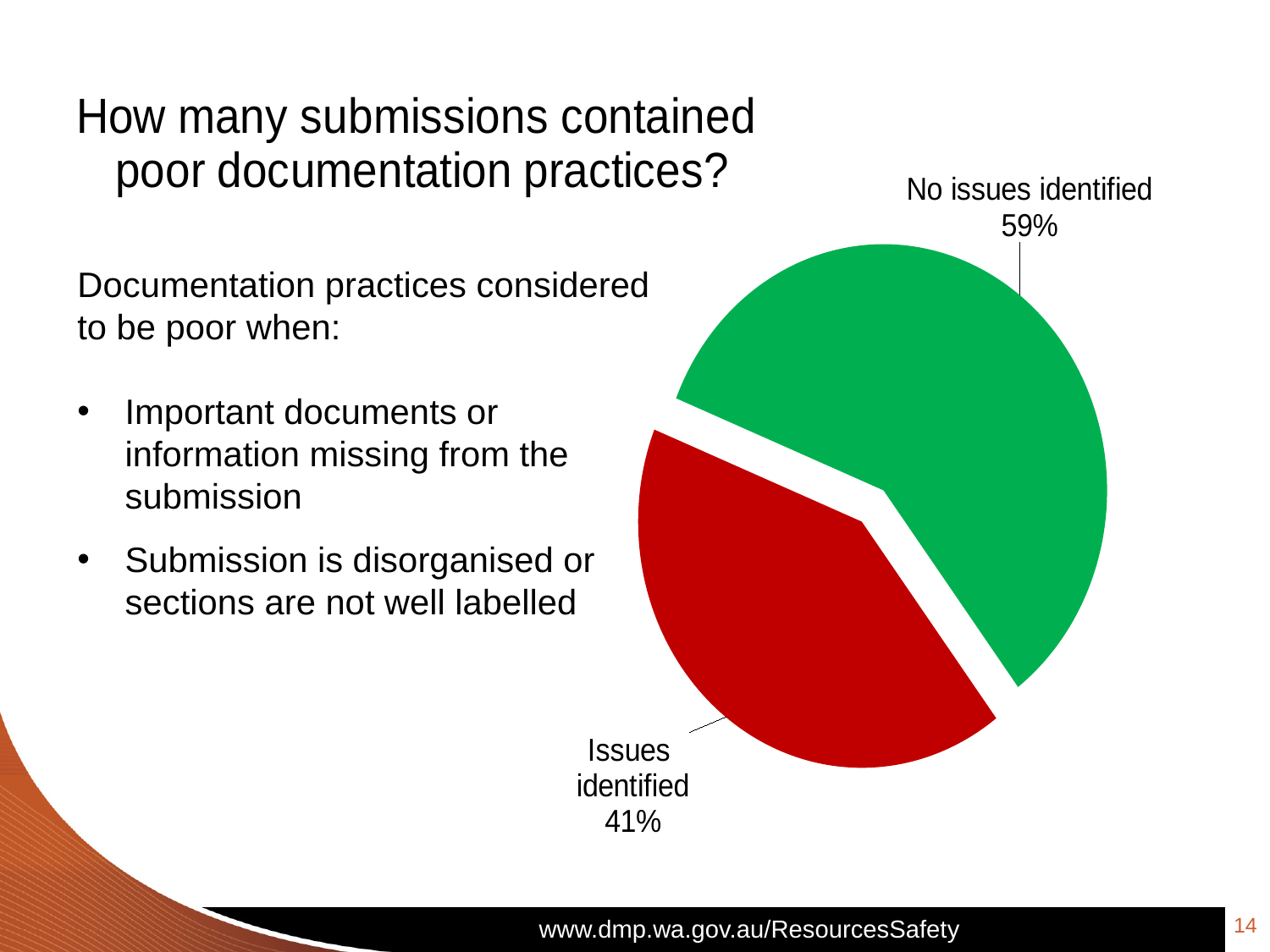
What is the difference in percentage points between the "No issues identified" slice and the "Issues identified" slice? 18 How many slices does the pie chart have? 2 Is the share for "Issues identified" greater or less than 50%? less What colour is the "Issues identified" slice? red What colour is the "No issues identified" slice? green What kind of chart is shown on the slide? pie chart Which is larger: the "Issues identified" slice or the "No issues identified" slice? No issues identified Which slice of the pie is the smallest? Issues identified What share of the pie is labelled "No issues identified"? 59% Which slice of the pie is the largest? No issues identified What share of the pie is labelled "Issues identified"? 41%